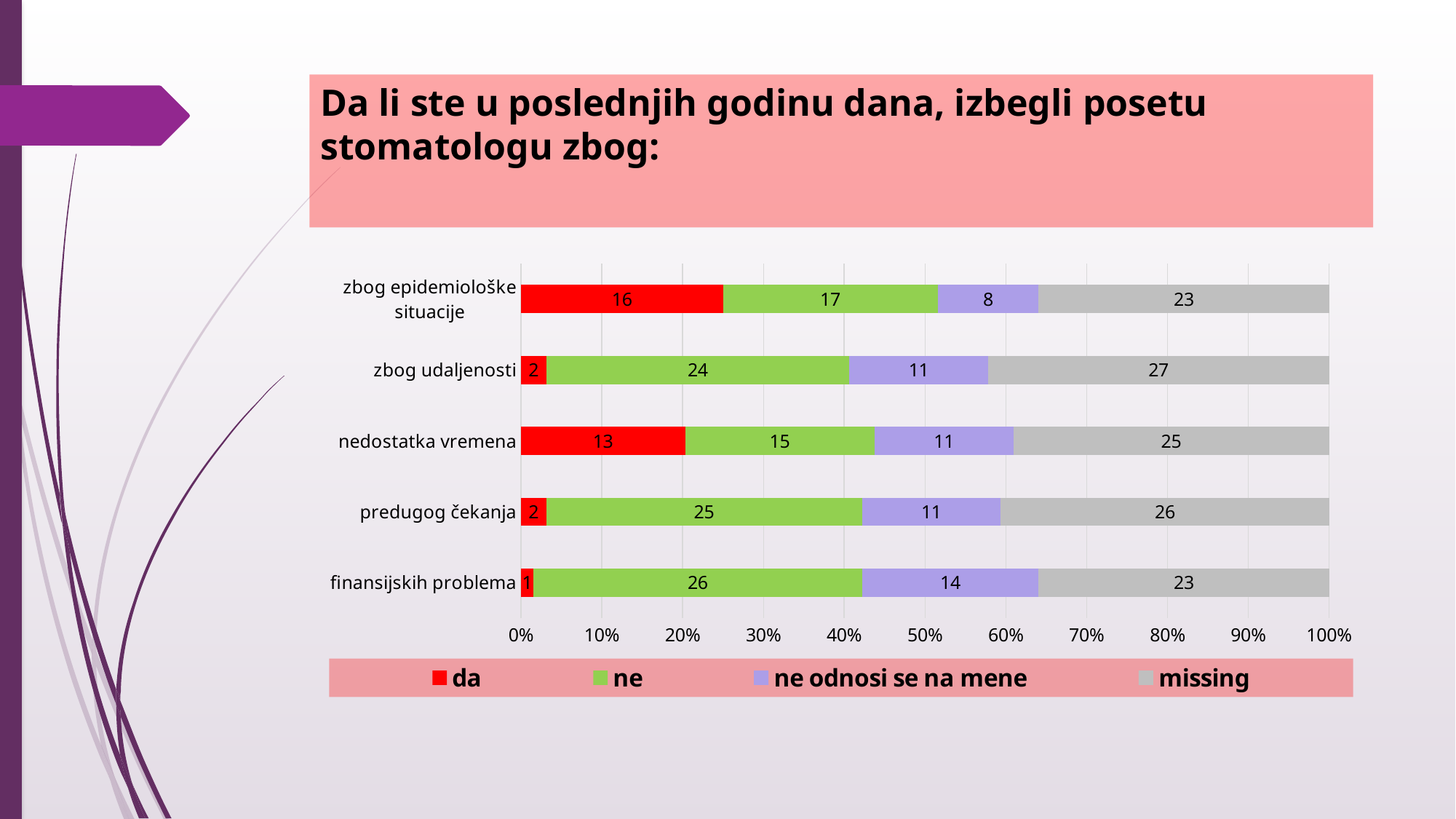
What is the value of "ne odnosi se na mene" for "nedostatka vremena"? 11 What is the value of "da" for "zbog epidemiološke situacije"? 16 What is the difference between the "ne" values for "finansijskih problema" and "nedostatka vremena"? 11 What kind of chart is shown on the slide? stacked bar chart How many categories are shown on the chart? 5 What is the value of "ne" for "finansijskih problema"? 26 How many series does the legend list? 4 What is the "missing" value for "zbog udaljenosti"? 27 Which category has the lowest "da" value? finansijskih problema Which is larger: the "missing" value for "zbog udaljenosti" or for "predugog čekanja"? zbog udaljenosti What is the total of all segments in the "predugog čekanja" bar? 64 Which category has the highest "da" value? zbog epidemiološke situacije